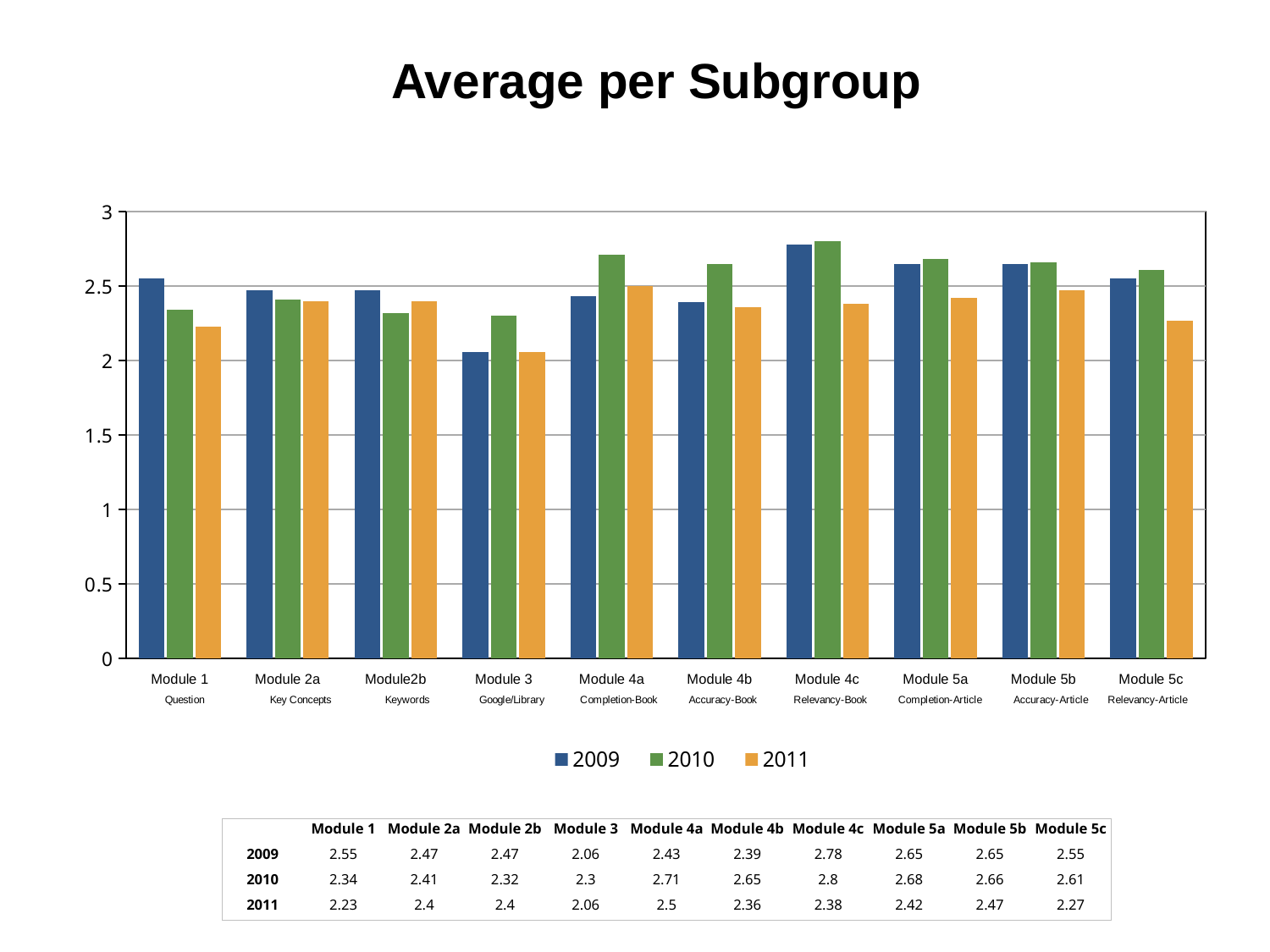
How many modules are shown on the x axis? 10 What type of chart is shown? Bar chart How many series does the legend list? 3 What is the difference between the 2010 and 2009 values for Module 4a? 0.28 Which module has the highest 2011 value? Module 4a Which module has the highest 2010 value? Module 4c What is the 2009 value for Module 4c? 2.78 Which module has the lowest 2009 value? Module 3 What is the difference between the 2009 and 2011 values for Module 1? 0.32 What is the 2011 value for Module 3? 2.06 What is the 2010 value for Module 4a? 2.71 For Module 4b, which is larger: the 2010 value or the 2011 value? 2010